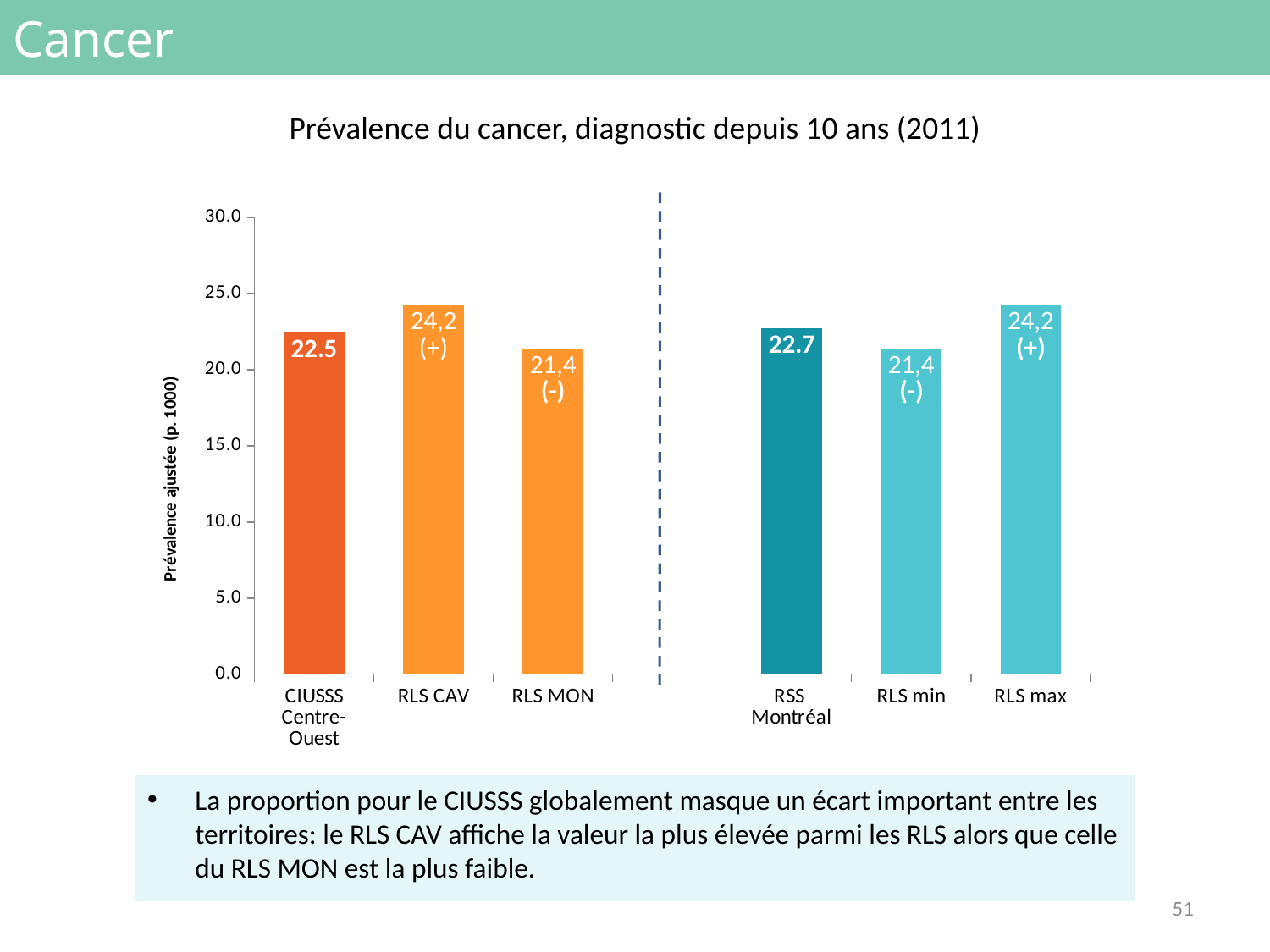
What is the value shown for RLS CAV? 24,2 What kind of chart is shown on the slide? Bar chart What is the value shown for RLS MON? 21,4 Among the three bars to the left of the dashed line, which category has the highest value? RLS CAV Among the three bars to the left of the dashed line, which category has the lowest value? RLS MON How many bars are plotted in the chart? 6 What is the value shown for RSS Montréal? 22.7 What is the value shown for RLS max? 24,2 What is the difference between the values for RLS CAV and RLS MON? 2,8 Which is larger, the value for RSS Montréal or the value for CIUSSS Centre-Ouest? RSS Montréal What is the value shown for CIUSSS Centre-Ouest? 22.5 What is the title of the chart? Prévalence du cancer, diagnostic depuis 10 ans (2011)